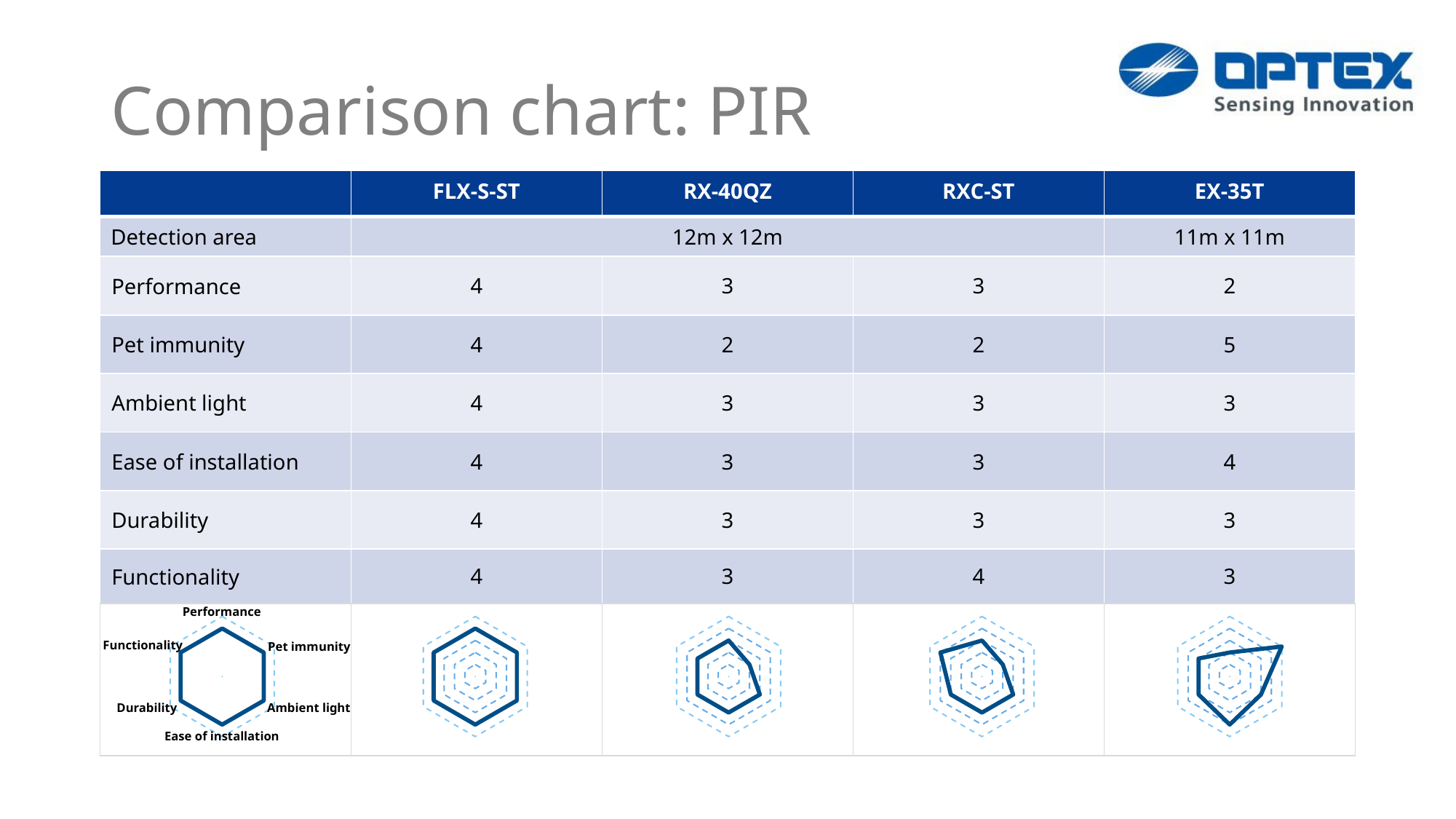
What is the difference between the Pet immunity values in the EX-35T and RX-40QZ radar charts? 3 In the RXC-ST radar chart, what is the value for Functionality? 4 Which is larger in the radar charts: Functionality for RXC-ST or Functionality for RX-40QZ? RXC-ST Which product's radar chart has the highest Pet immunity value? EX-35T Which product's radar chart has the lowest Performance value? EX-35T What kind of chart is shown beneath each product column in the bottom row of the table? radar chart In the FLX-S-ST radar chart, what is the value for Performance? 4 How many radar charts are plotted for the products (excluding the legend chart)? 4 How many axes (categories) does the legend radar chart at the bottom left show? 6 Which axis label appears at the top of the legend radar chart? Performance In the EX-35T radar chart, what is the value for Pet immunity? 5 In the RX-40QZ radar chart, what is the value for Pet immunity? 2